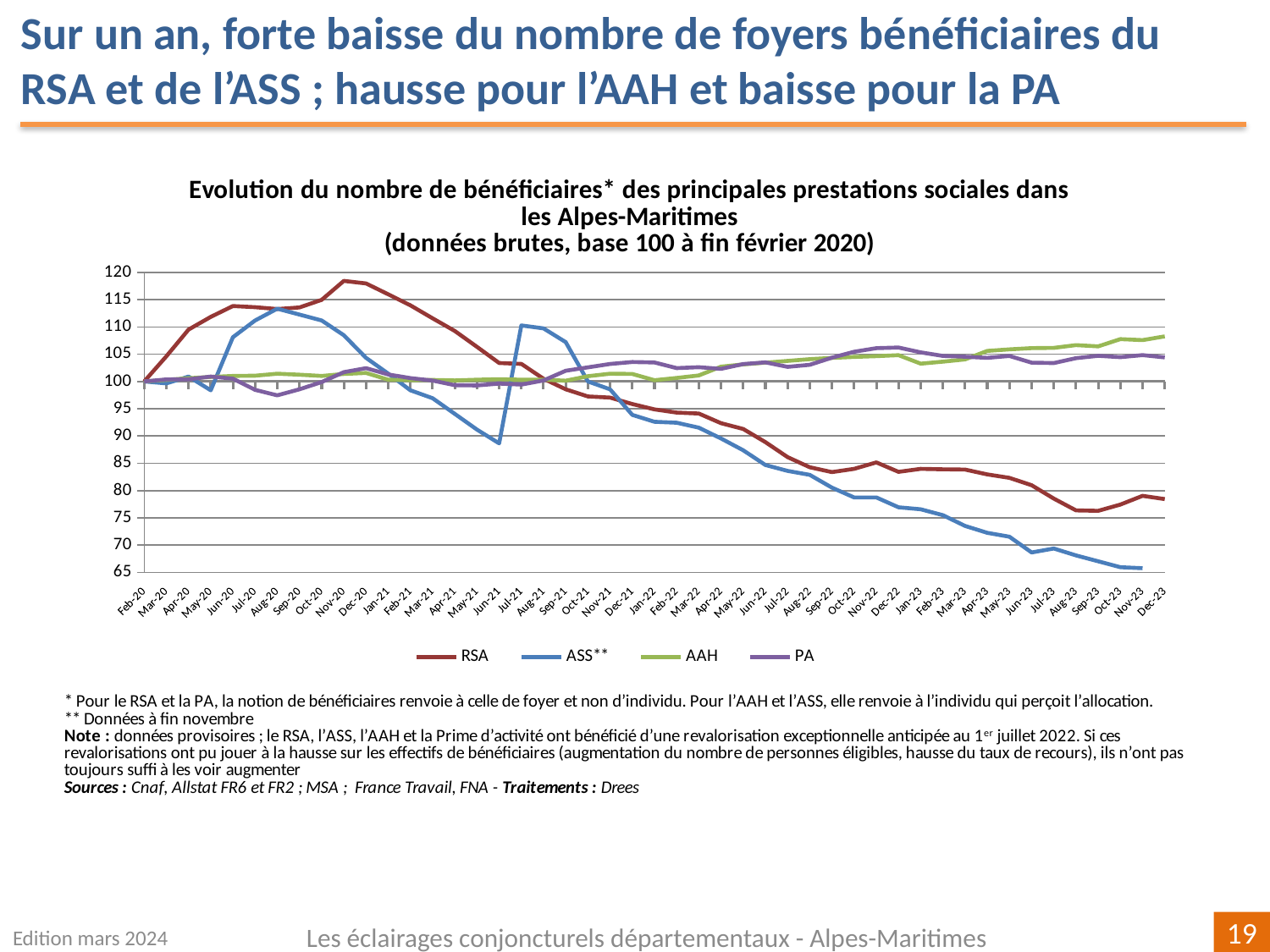
Which series is the lowest at Dec-23? RSA Which series is the highest at Dec-23? AAH Is the value for RSA at Nov-20 greater or less than 115? greater Does the RSA series rise or fall between Nov-20 and Dec-23? fall Is the value for AAH at Dec-23 greater or less than 105? greater Is the value for RSA at Dec-23 greater or less than 85? less At Dec-23, which is larger: the value for AAH or the value for RSA? AAH How many series does the legend list? 4 What colour is the RSA line in the chart? red What kind of chart is shown on the slide? line chart